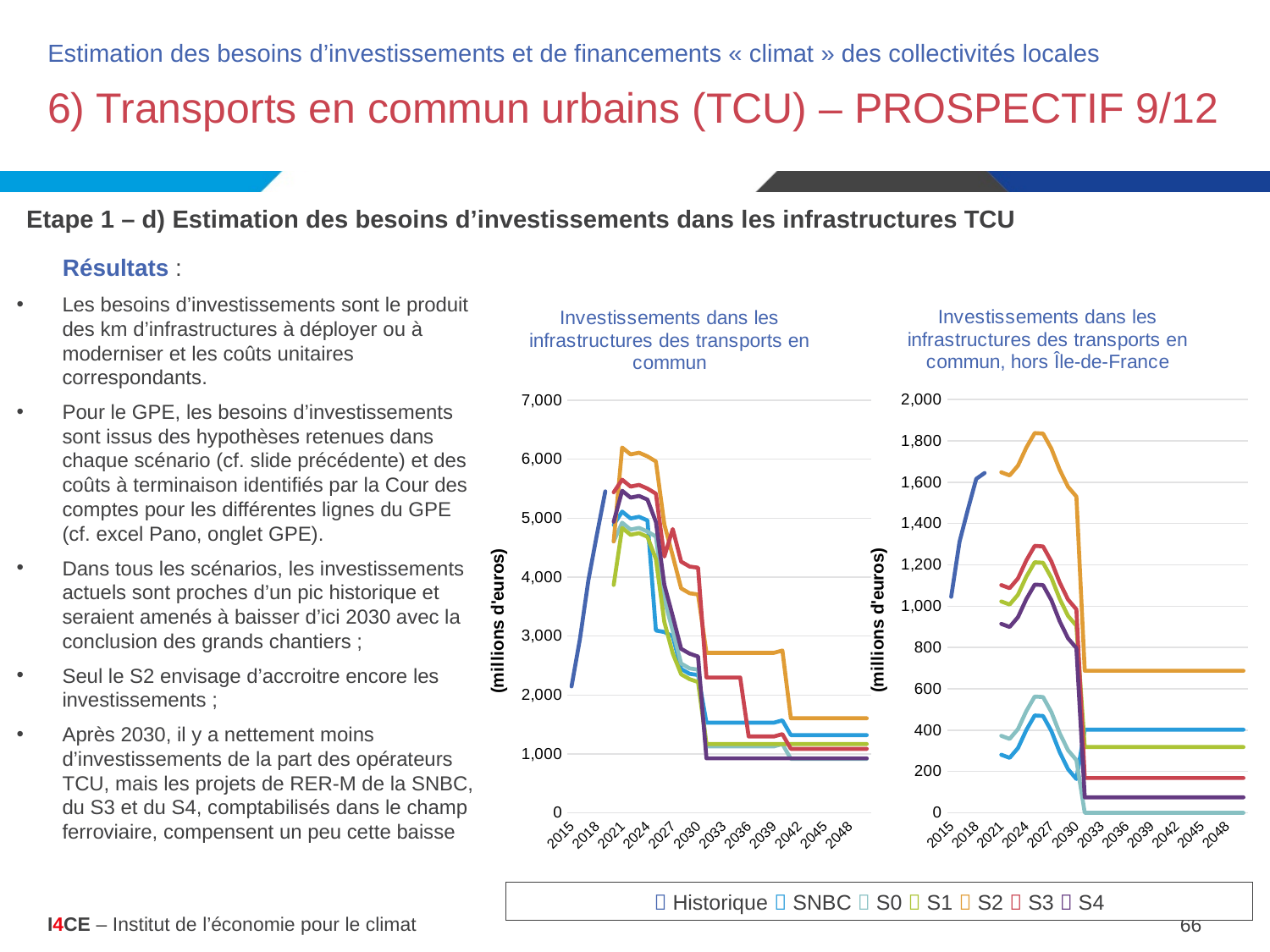
In the right chart (hors Île-de-France), is the value of S2 in 2045 greater or less than 600? greater What type of chart is the left chart titled "Investissements dans les infrastructures des transports en commun"? line chart In the left chart (Investissements dans les infrastructures des transports en commun), which series has the highest value in 2045? S2 In the right chart (hors Île-de-France), is the peak value of the S2 series greater or less than 1,800? greater What is the y-axis label of the right chart, "Investissements dans les infrastructures des transports en commun, hors Île-de-France"? (millions d'euros) In the right chart (hors Île-de-France), is the value of S0 in 2045 greater or less than 200? less In the right chart (hors Île-de-France), does the S2 series rise or fall between 2027 and 2033? fall How many series does the legend list for the charts on the slide? 7 What is the title of the right chart? Investissements dans les infrastructures des transports en commun, hors Île-de-France In the right chart (hors Île-de-France), which series has the lowest value in 2045? S0 In the right chart (hors Île-de-France), which is larger in 2045, S2 or S4? S2